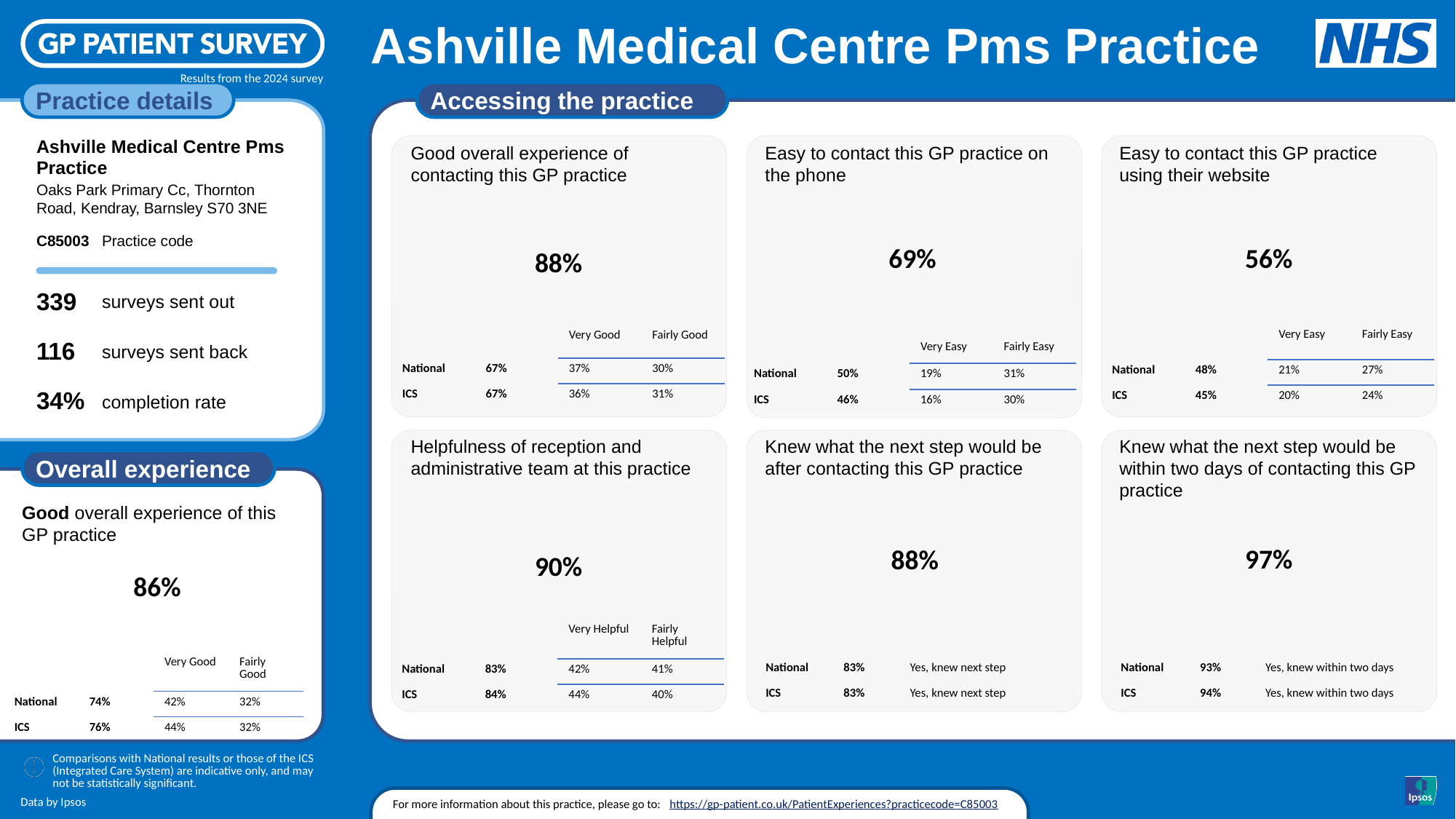
In the 'Knew what the next step would be within two days of contacting this GP practice' panel, what is the practice's headline percentage? 97% In the 'Good overall experience of contacting this GP practice' panel, what is the total of the National Very Good and Fairly Good values? 67% In the 'Easy to contact this GP practice on the phone' panel, what is the difference between the National value and the ICS value? 4% In the 'Overall experience' panel, which is larger: the National value or the ICS value? ICS In the 'Easy to contact this GP practice on the phone' panel, what is the practice's headline percentage? 69% In the 'Easy to contact this GP practice using their website' panel, what is the National value? 48% Among the six 'Accessing the practice' panels, which has the lowest headline percentage? Easy to contact this GP practice using their website Among the six 'Accessing the practice' panels, which has the highest headline percentage? Knew what the next step would be within two days of contacting this GP practice In the 'Helpfulness of reception and administrative team at this practice' panel, what is the ICS value for Very Helpful? 44% In the 'Good overall experience of contacting this GP practice' panel, what is the practice's headline percentage? 88% How many panels are shown under the 'Accessing the practice' heading? 6 In the 'Knew what the next step would be after contacting this GP practice' panel, what is the ICS value? 83%